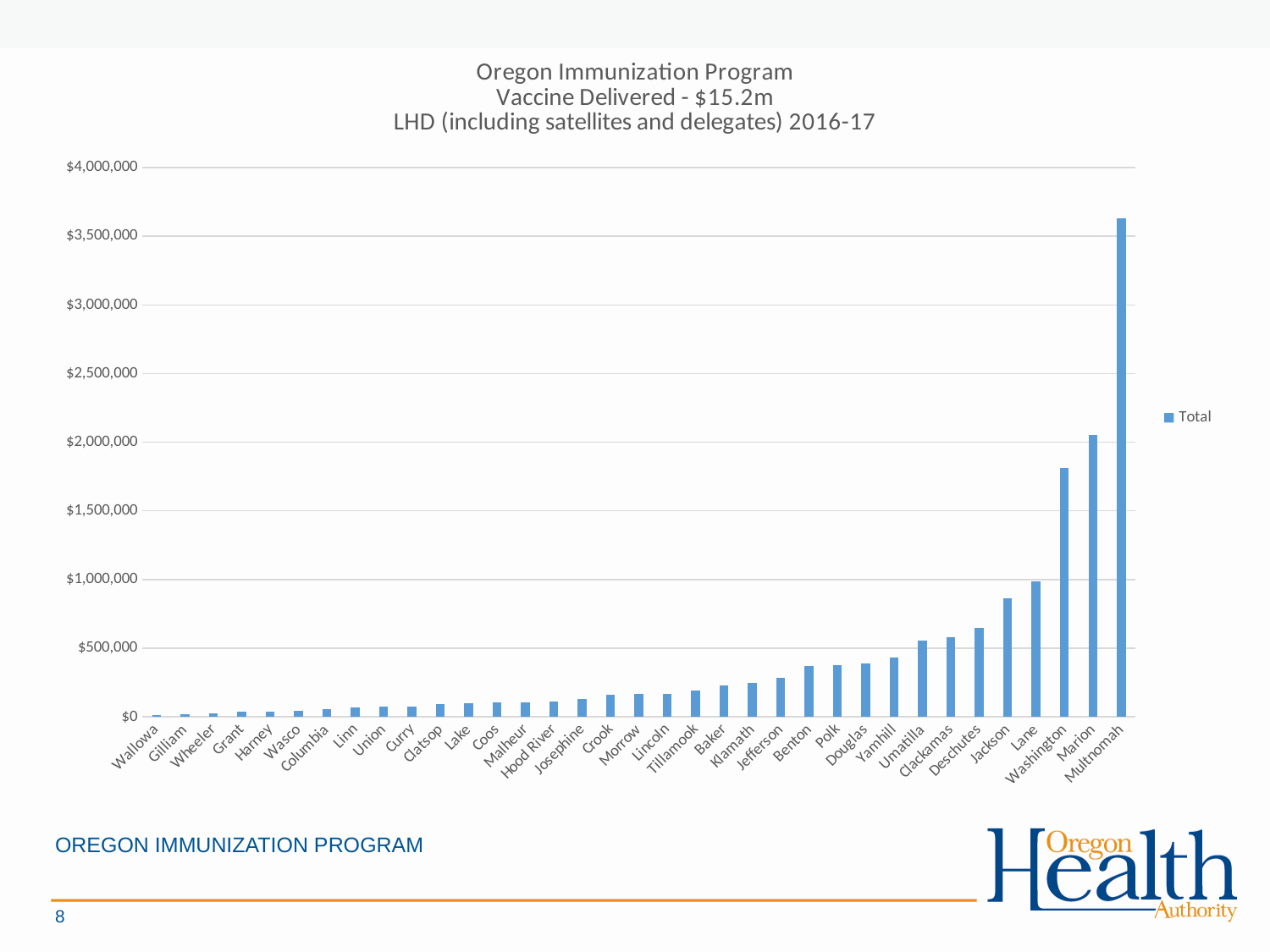
Which is larger, the value for Washington or the value for Marion? Marion Is the value for Multnomah greater or less than $3,500,000? greater Do the values rise or fall moving left to right along the x axis? rise How many LHDs (categories) are plotted on the x axis? 35 Which LHD has the lowest vaccine delivered value? Wallowa According to the chart title, what is the total value of vaccine delivered? $15.2m Which LHD has the highest vaccine delivered value? Multnomah What kind of chart is shown on the slide? bar chart Is the value for Marion greater or less than $2,000,000? greater What is the name of the series shown in the legend? Total How many series does the legend list? 1